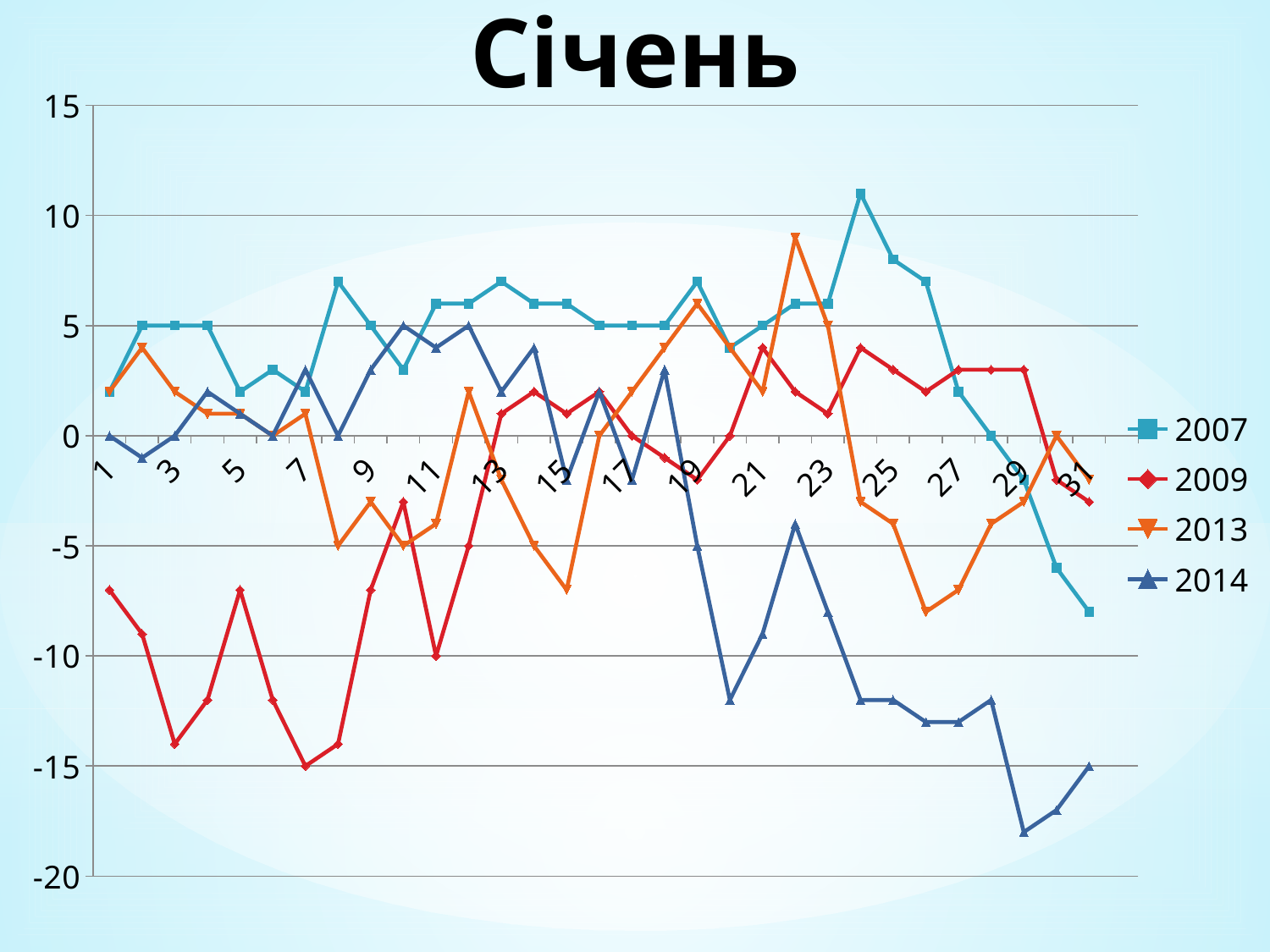
How many days (points) are plotted along the x axis for each series? 31 Is the value for 2014 on day 29 greater or less than -15? less Is the value for 2007 on day 24 greater or less than 10? greater Is the value for 2013 on day 22 greater or less than 5? greater On day 1, which is larger: the value for 2007 or the value for 2009? 2007 What kind of chart is shown on the slide? line chart Which years are listed in the legend? 2007, 2009, 2013, 2014 How many series does the legend list? 4 Which series reaches the highest point on the chart? 2007 Which series reaches the lowest point on the chart? 2014 What is the title of the chart? Січень